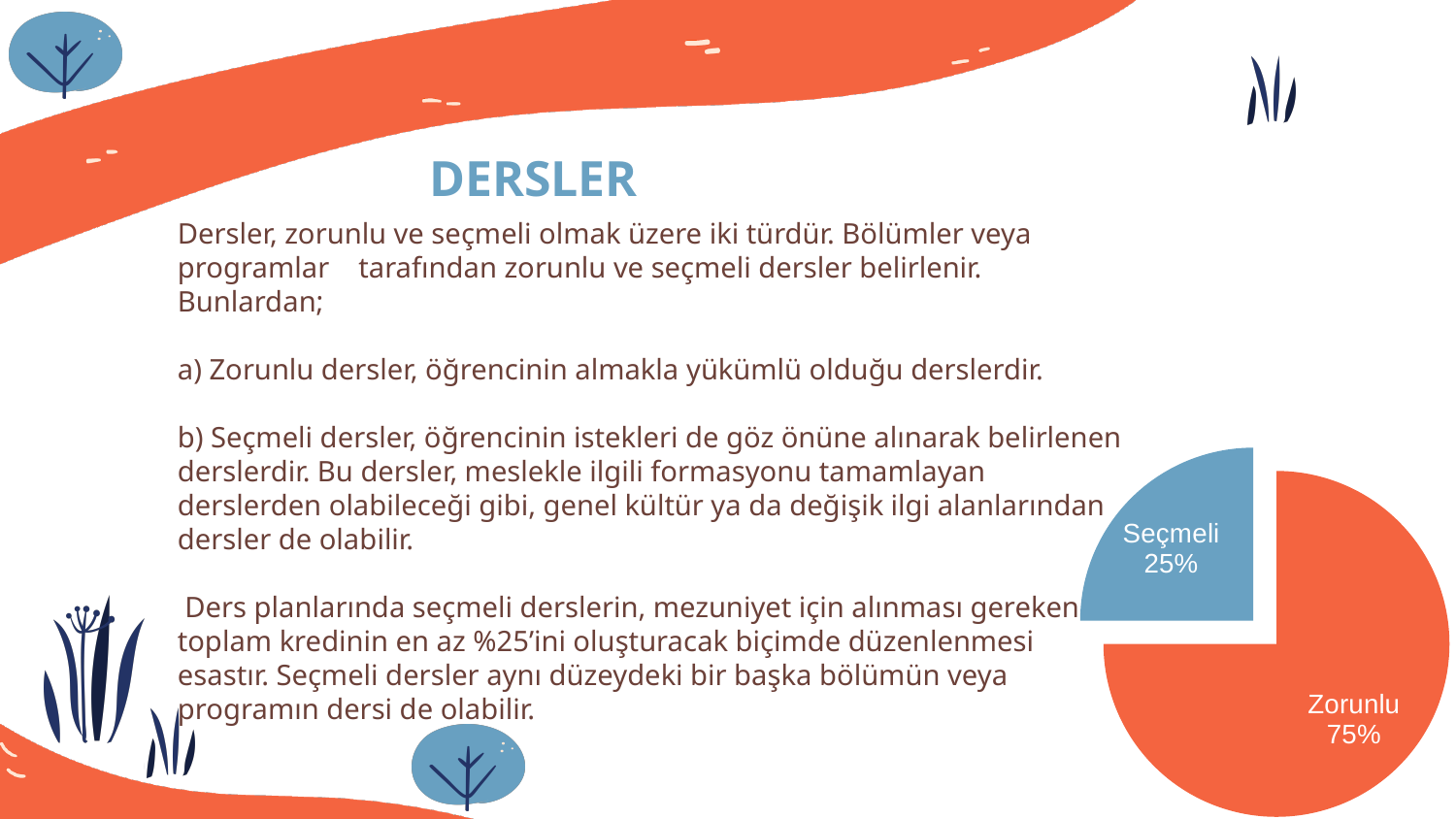
What colour is the Zorunlu slice of the pie chart? orange What is the value printed on the blue slice of the pie chart? 25% Which slice of the pie chart is the largest? Zorunlu What is the difference in percentage points between the Zorunlu and Seçmeli slices? 50 What is the value printed on the orange slice of the pie chart? 75% What colour is the Seçmeli slice of the pie chart? blue Which slice of the pie chart is the smallest? Seçmeli What share of the pie does the Zorunlu slice represent? 75% What kind of chart is shown on the slide? pie chart What share of the pie does the Seçmeli slice represent? 25% Which is larger in the pie chart, Seçmeli or Zorunlu? Zorunlu How many slices does the pie chart have? 2